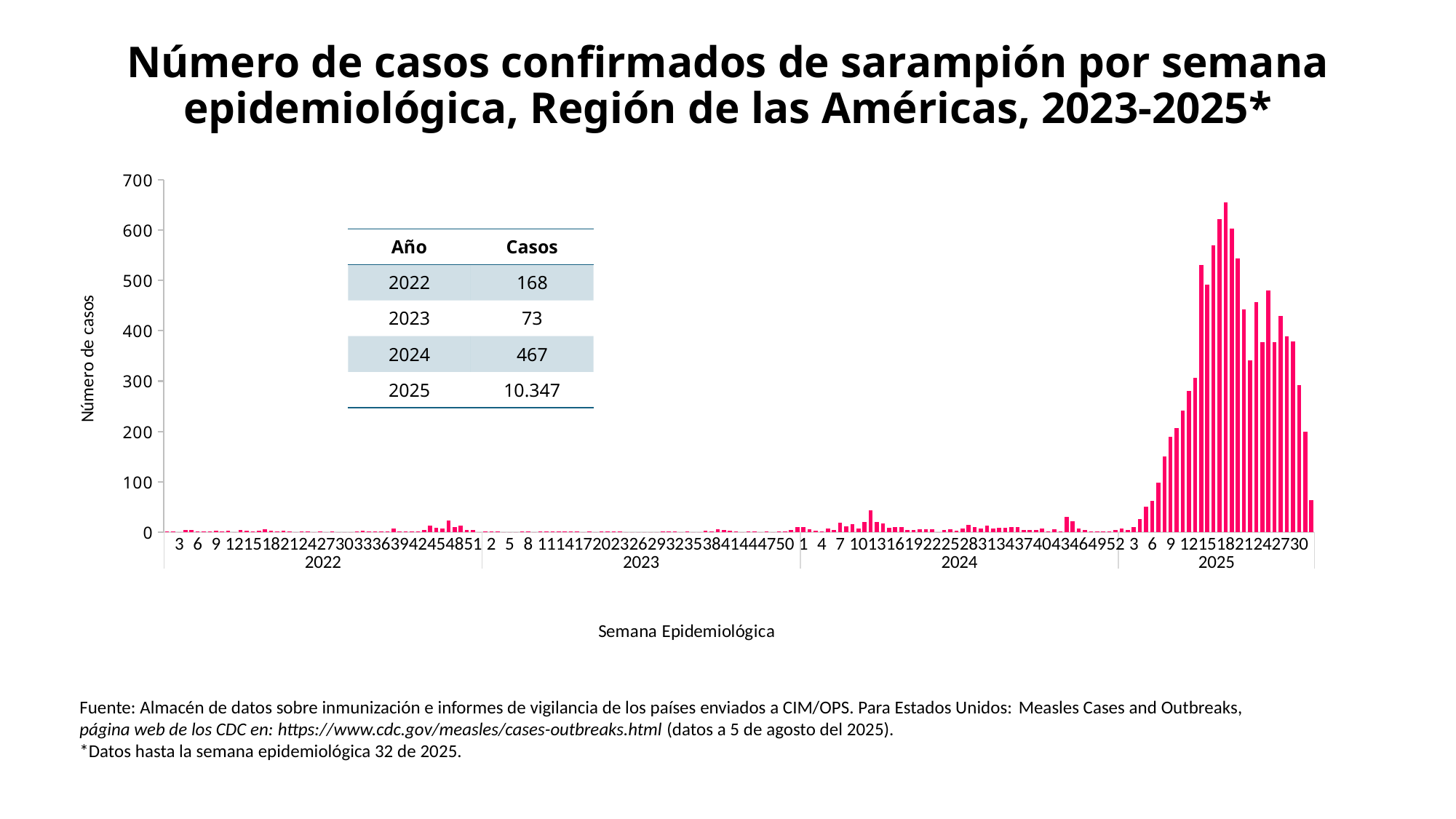
According to the inset table, which year had the fewest cases? 2023 What is the label of the vertical axis of the chart? Número de casos What kind of chart is shown on the slide? bar chart Is the value of the tallest weekly bar in 2024 greater or less than 100? less What is the label of the horizontal axis of the chart? Semana Epidemiológica According to the inset table, how many cases were there in 2022? 168 According to the inset table, what is the difference in cases between 2024 and 2023? 394 How many years are shown along the x axis of the chart? 4 According to the inset table, which year had more cases, 2022 or 2024? 2024 Is the value of the tallest weekly bar in 2025 greater or less than 600? greater According to the inset table, how many cases were there in 2025? 10.347 In which year do the weekly bars reach their highest values? 2025